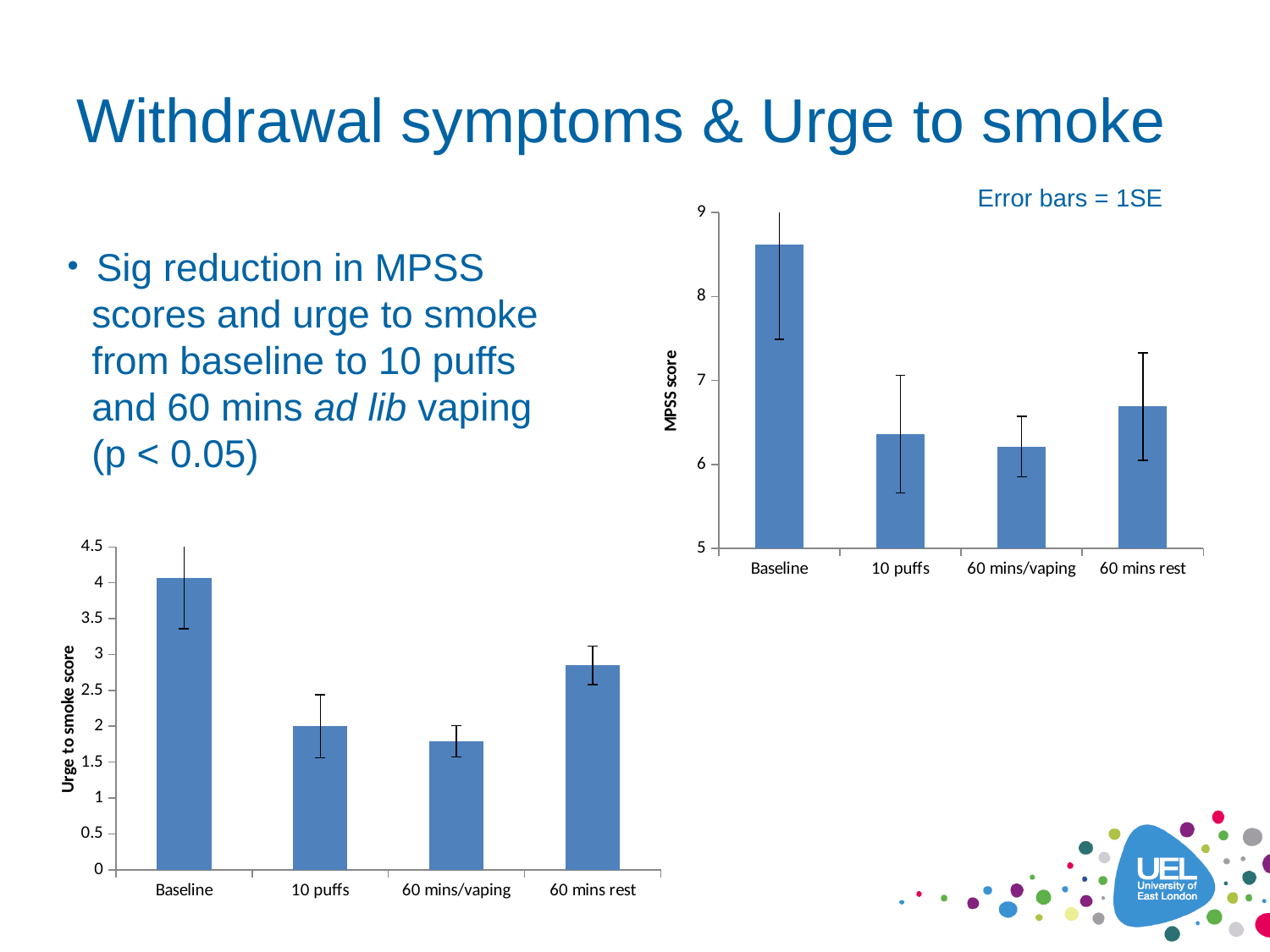
In the MPSS score chart, is the value for Baseline greater or less than 8? greater In the Urge to smoke score chart, which is larger, the value for 10 puffs or the value for 60 mins rest? 60 mins rest What kind of chart is the MPSS score chart? Bar chart In the Urge to smoke score chart, is the value for 60 mins rest greater or less than 3? less According to the note above the MPSS score chart, what do the error bars represent? 1SE In the MPSS score chart, which is larger, the value for Baseline or the value for 60 mins rest? Baseline How many categories are shown on the x axis of the MPSS score chart? 4 In the MPSS score chart, which category has the highest value? Baseline In the Urge to smoke score chart, does the value rise or fall from Baseline to 10 puffs? fall In the MPSS score chart, is the value for 60 mins rest greater or less than 7? less In the Urge to smoke score chart, which category has the highest value? Baseline